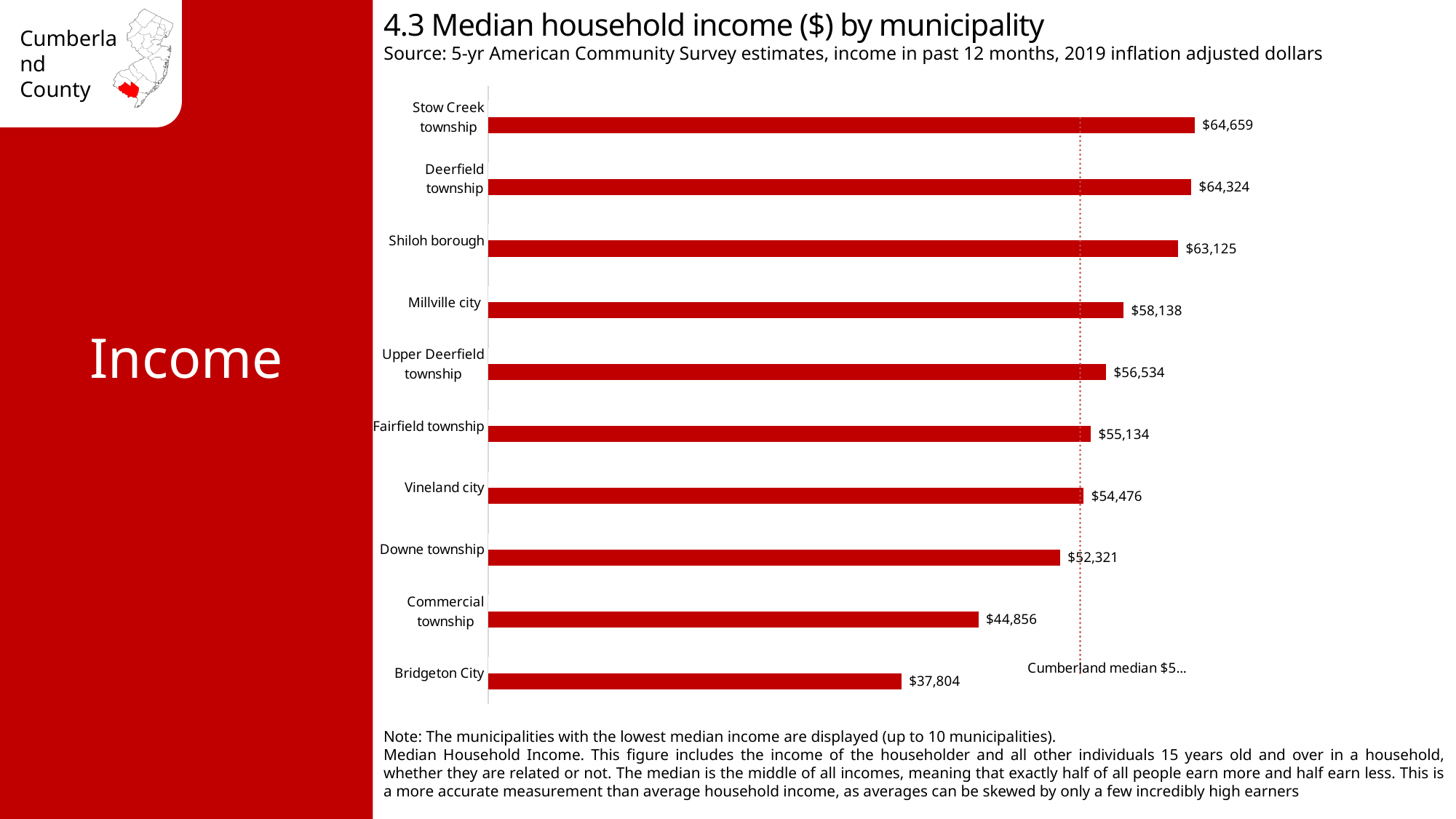
What is the median household income for Vineland city? $54,476 What is the difference in median household income between Stow Creek township and Bridgeton City? $26,855 What is the median household income for Bridgeton City? $37,804 What type of chart is used to show median household income by municipality? Bar chart What is the title of the chart? 4.3 Median household income ($) by municipality What is the difference in median household income between Commercial township and Bridgeton City? $7,052 How many municipalities are shown on the chart? 10 Which municipality has the highest median household income on the chart? Stow Creek township What is the median household income for Commercial township? $44,856 Which has a higher median household income, Millville city or Vineland city? Millville city What is the median household income for Stow Creek township? $64,659 Which municipality has the lowest median household income on the chart? Bridgeton City